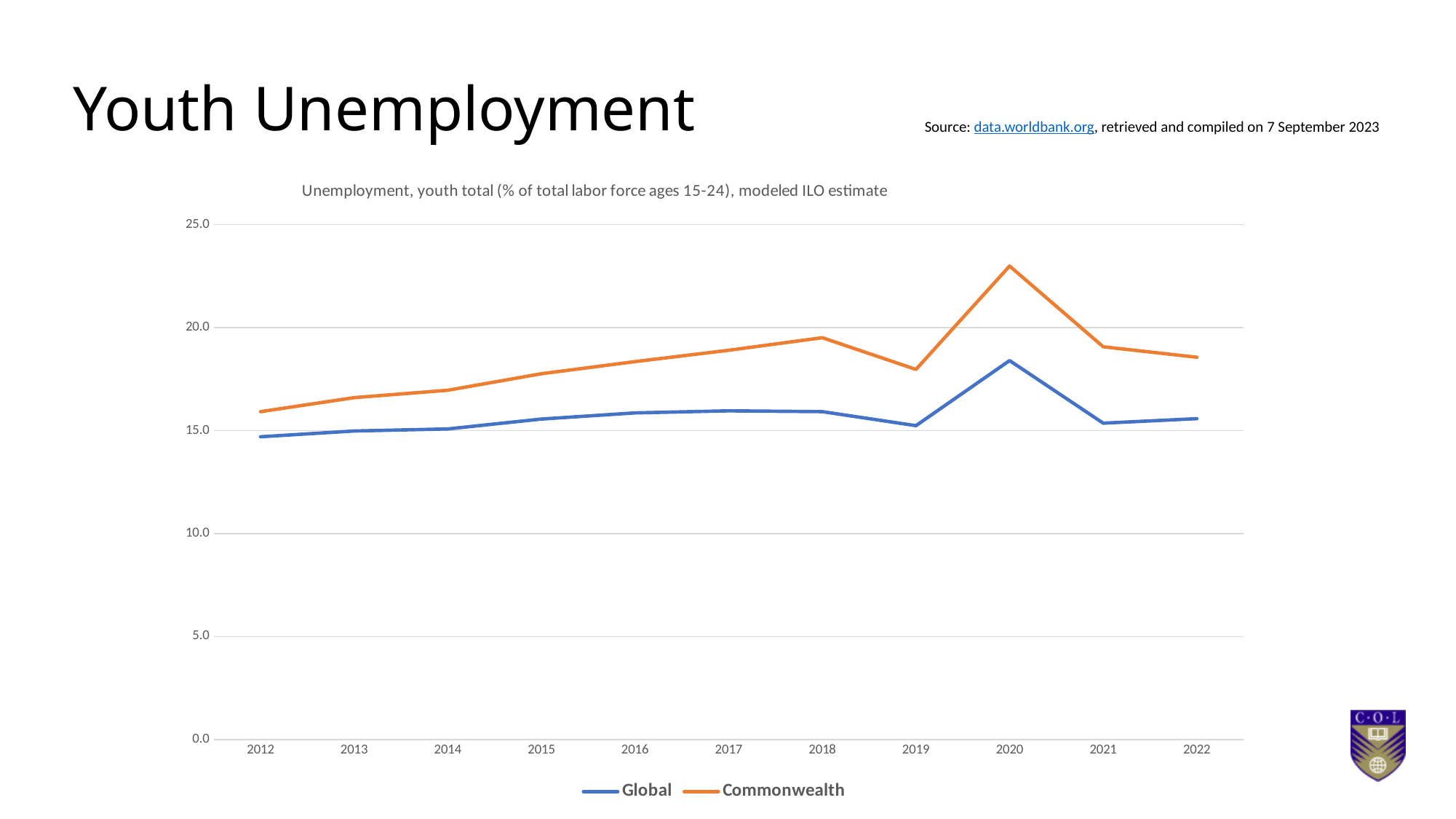
In which year is the Global series at its lowest value? 2012 How many series does the legend list? 2 Does the Global series rise or fall from 2012 to 2018? rise How many years are plotted along the x axis? 11 Is the Commonwealth value for 2020 greater or less than 20.0? greater In which year does the Commonwealth series reach its highest value? 2020 In 2020, which series has the higher value, Global or Commonwealth? Commonwealth Which series is drawn in orange? Commonwealth What kind of chart is shown on the slide? line chart In which year does the Global series reach its highest value? 2020 Is the Commonwealth value for 2018 greater or less than 20.0? less Is the Global value for 2012 greater or less than 15.0? less